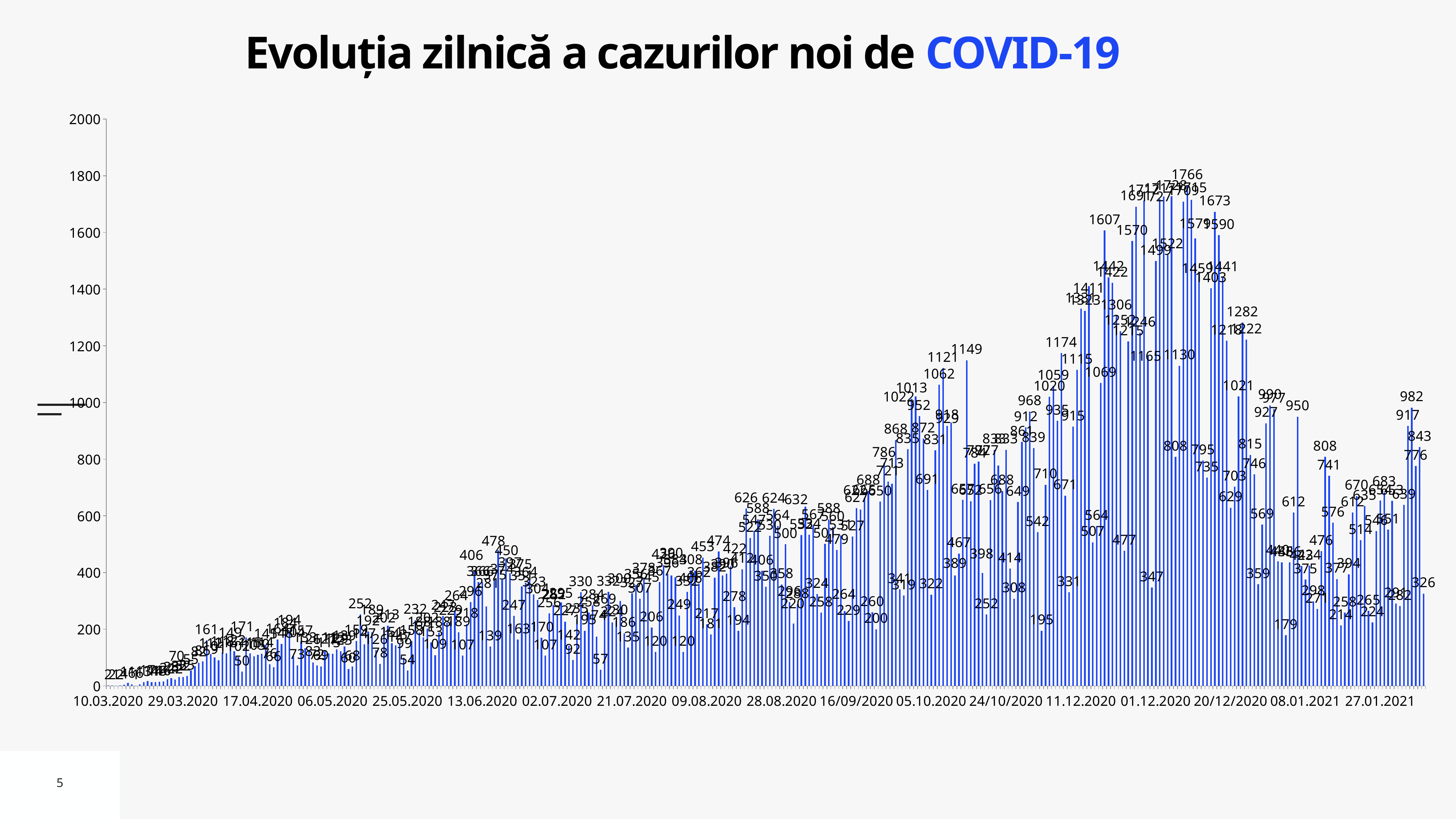
Which is larger: the peak value around June 2020 (478) or the peak value around December 2020 (1766)? 1766 What is the maximum value shown on the vertical axis? 2000 Overall, do the daily values rise or fall from March 2020 to December 2020? rise What is the title of the chart? Evoluția zilnică a cazurilor noi de COVID-19 Is the highest bar on the chart greater or less than 1800? less What is the first date label on the horizontal axis? 10.03.2020 What kind of chart is shown on the slide? bar chart Is the highest bar around 13.06.2020 greater or less than 600? less What is the last date label on the horizontal axis? 27.01.2021 Is the highest bar on the chart greater or less than 1600? greater What is the interval between consecutive tick marks on the vertical axis? 200 What is the highest daily value labelled on the chart? 1766